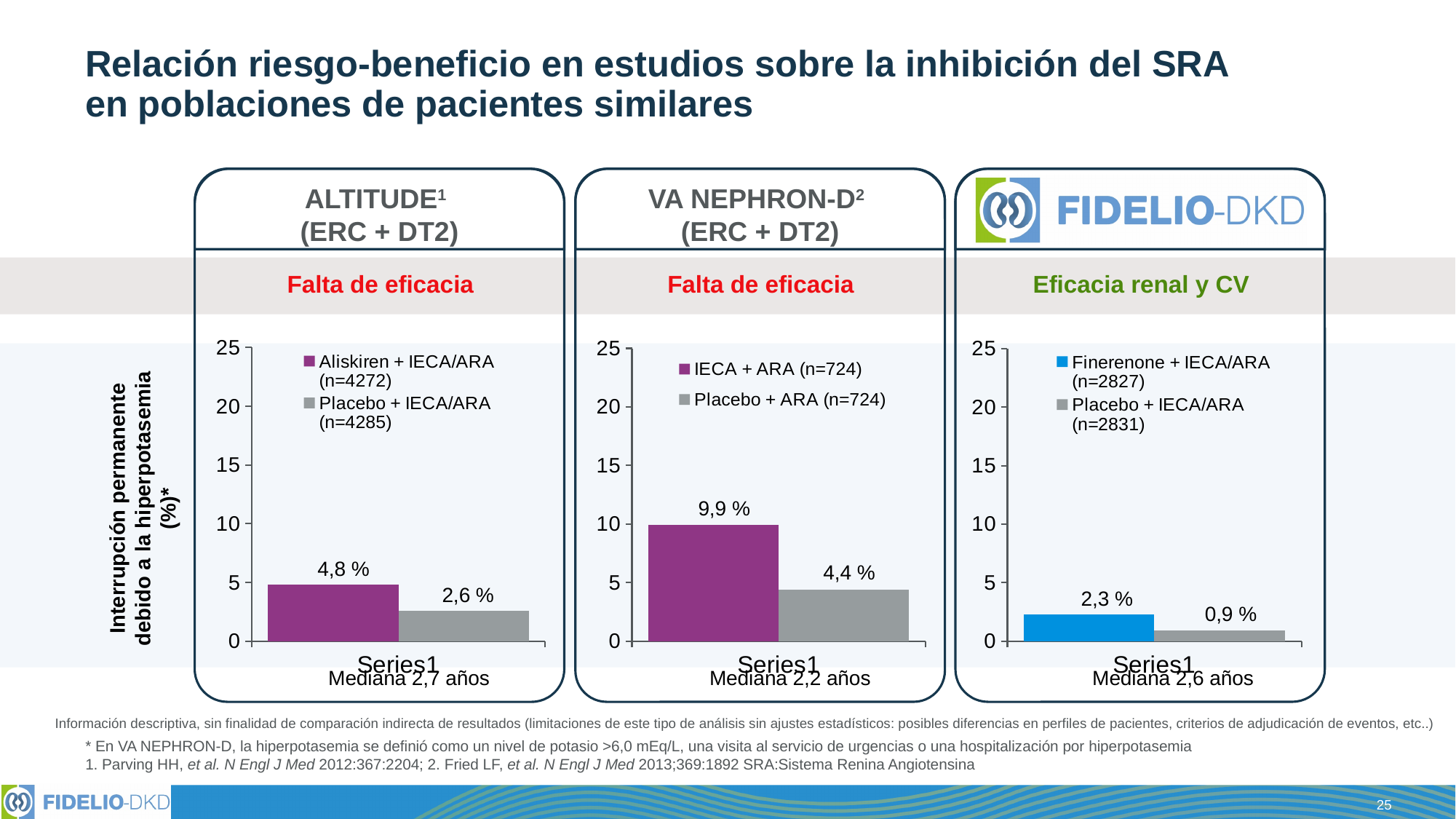
What kind of chart is the FIDELIO-DKD chart? bar chart How many series does the legend of the FIDELIO-DKD chart list? 2 In the VA NEPHRON-D chart, what is the value for IECA + ARA (n=724)? 9,9 % In the FIDELIO-DKD chart, what is the value for Finerenone + IECA/ARA (n=2827)? 2,3 % In the ALTITUDE chart, what is the value for Placebo + IECA/ARA (n=4285)? 2,6 % In the VA NEPHRON-D chart, what is the difference between the IECA + ARA value and the Placebo + ARA value? 5,5 % In the VA NEPHRON-D chart, is the value for IECA + ARA greater or less than 5? greater In the ALTITUDE chart, which series has the higher value, Aliskiren + IECA/ARA or Placebo + IECA/ARA? Aliskiren + IECA/ARA In the FIDELIO-DKD chart, what colour is the bar for Finerenone + IECA/ARA? blue In the FIDELIO-DKD chart, what is the value for Placebo + IECA/ARA (n=2831)? 0,9 % In the ALTITUDE chart, what is the value for Aliskiren + IECA/ARA (n=4272)? 4,8 % In the VA NEPHRON-D chart, what is the value for Placebo + ARA (n=724)? 4,4 %